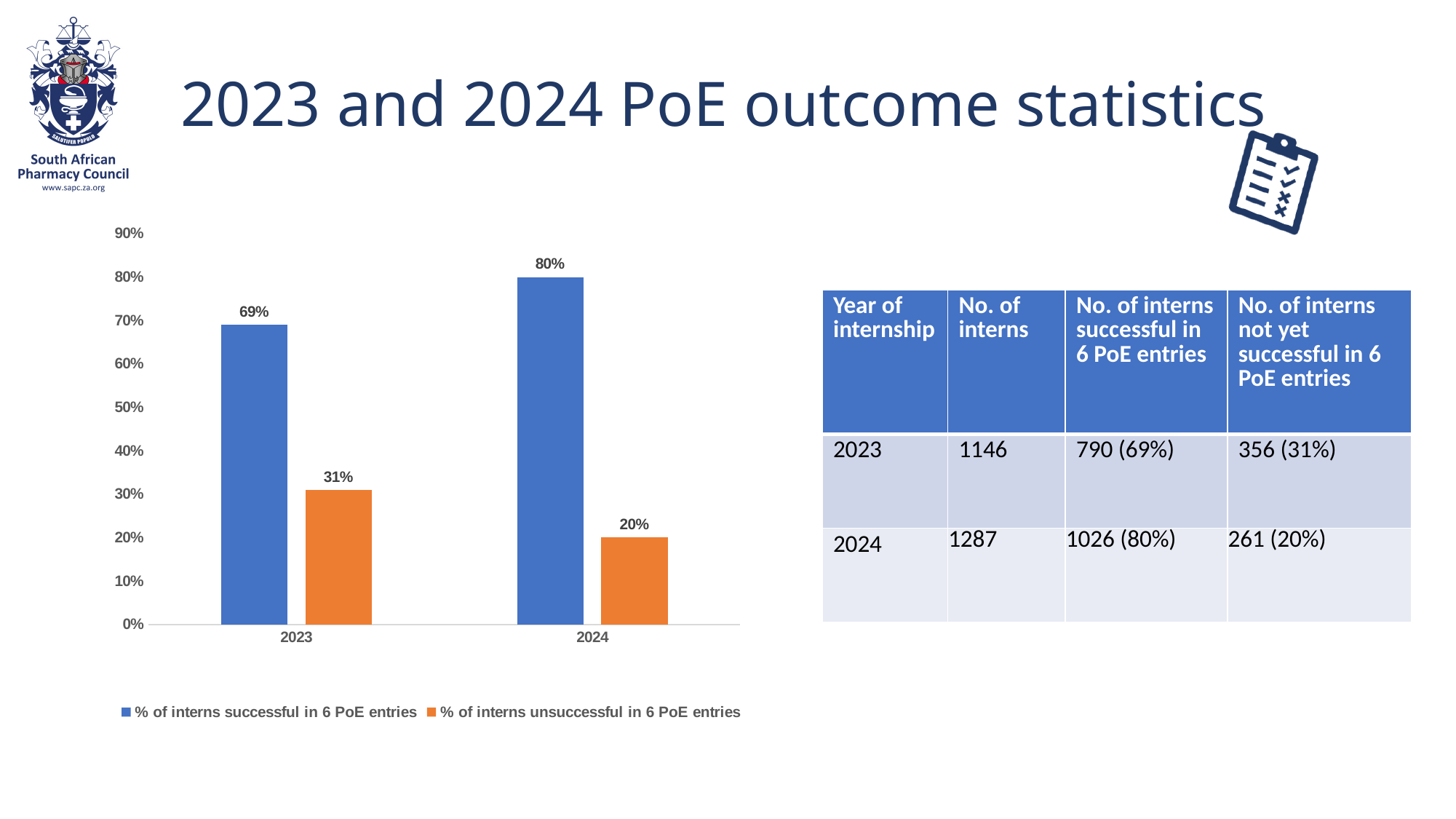
Which year has the higher percentage of interns successful in 6 PoE entries? 2024 What kind of chart is shown on the slide? Bar chart How many years are shown on the x axis of the chart? 2 What percentage of interns were successful in 6 PoE entries in 2023? 69% By how many percentage points did the share of interns successful in 6 PoE entries increase from 2023 to 2024? 11 percentage points How many series does the chart legend list? 2 What percentage of interns were successful in 6 PoE entries in 2024? 80% What percentage of interns were unsuccessful in 6 PoE entries in 2023? 31% What percentage of interns were unsuccessful in 6 PoE entries in 2024? 20% Which year has the lower percentage of interns unsuccessful in 6 PoE entries? 2024 Is the value for interns successful in 6 PoE entries in 2023 greater or less than 60%? greater Is the percentage of interns unsuccessful in 6 PoE entries larger in 2023 or in 2024? 2023